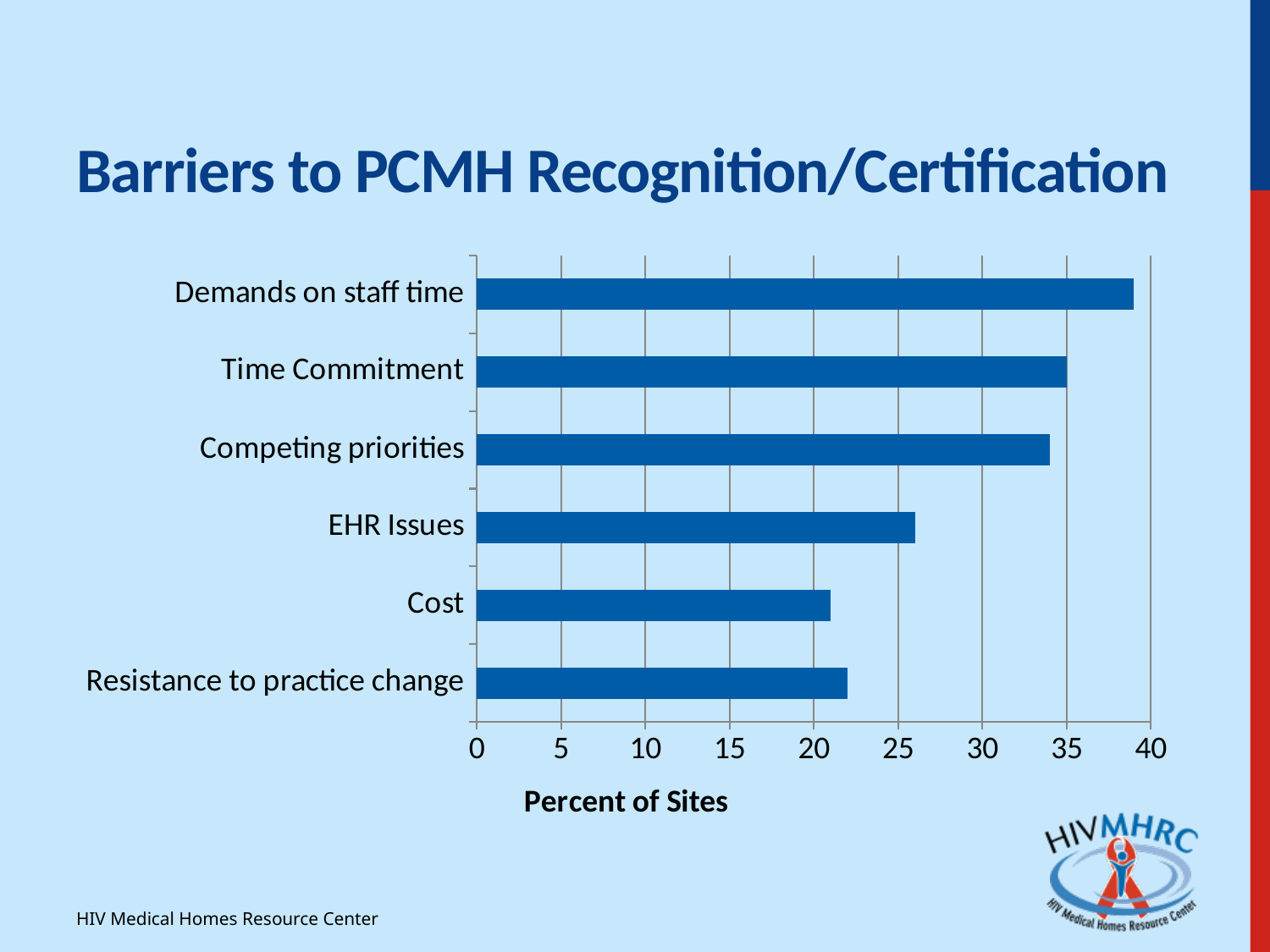
Is the value for Resistance to practice change greater or less than 25? less What is the label on the horizontal axis of the chart? Percent of Sites Which barrier has the highest percent of sites? Demands on staff time Is the value for Cost greater or less than 25? less What is the title of the slide containing the chart? Barriers to PCMH Recognition/Certification How many barriers (categories) are plotted in the chart? 6 Is the value for Competing priorities greater or less than 30? greater Which has a higher percent of sites, Demands on staff time or EHR Issues? Demands on staff time What kind of chart is shown on the slide? bar chart Which has a higher percent of sites, EHR Issues or Cost? EHR Issues